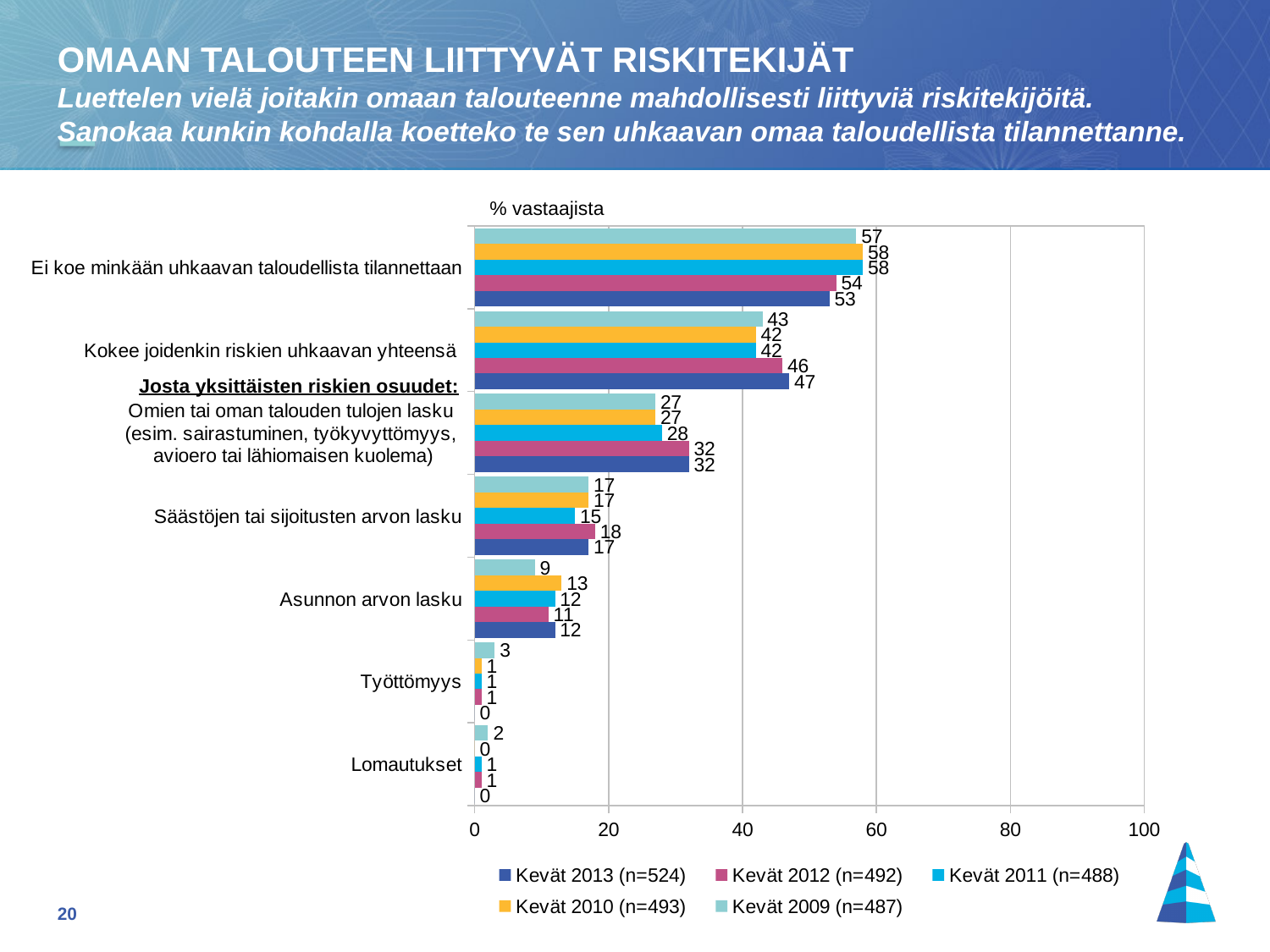
What is the value for Kevät 2009 (n=487) in the category 'Kokee joidenkin riskien uhkaavan yhteensä'? 43 What is the value for Kevät 2009 (n=487) in the category 'Asunnon arvon lasku'? 9 What type of chart is shown on the slide? bar chart How many series does the legend list? 5 What is the difference between the Kevät 2013 (n=524) and Kevät 2009 (n=487) values for 'Omien tai oman talouden tulojen lasku'? 5 What is the value for Kevät 2009 (n=487) in the category 'Työttömyys'? 3 What is the value for Kevät 2013 (n=524) in the category 'Ei koe minkään uhkaavan taloudellista tilannettaan'? 53 What label is shown above the chart's plot area describing the unit of the values? % vastaajista How many categories are plotted on the chart? 7 Which is larger for 'Kokee joidenkin riskien uhkaavan yhteensä': the Kevät 2013 (n=524) value or the Kevät 2010 (n=493) value? Kevät 2013 (n=524) What is the value for Kevät 2011 (n=488) in the category 'Säästöjen tai sijoitusten arvon lasku'? 15 Which category has the highest value for Kevät 2013 (n=524)? Ei koe minkään uhkaavan taloudellista tilannettaan